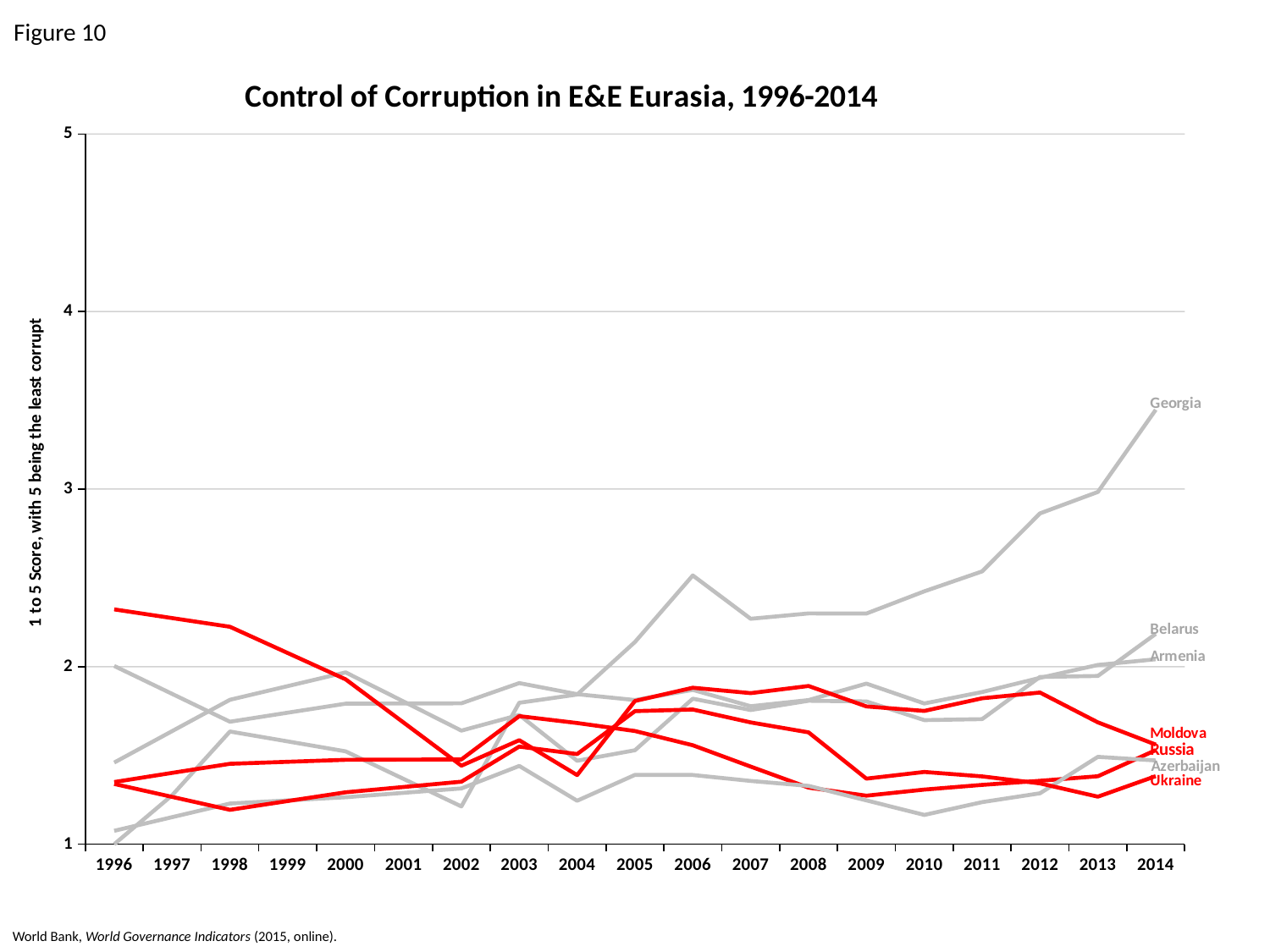
Which country has the higher score in 2014, Moldova or Ukraine? Moldova Does Georgia's score rise or fall between 2009 and 2014? rise Which country has the highest Control of Corruption score in 2014? Georgia Is the value for Ukraine in 2014 greater or less than 2? less How many countries are plotted as lines on the chart? 7 What is the label on the vertical axis of the chart? 1 to 5 Score, with 5 being the least corrupt What is the title of the chart? Control of Corruption in E&E Eurasia, 1996-2014 How many years are shown along the x axis of the chart? 19 What kind of chart is shown on the slide? line chart Is the value for Georgia in 2014 greater or less than 3? greater Is the value for Georgia in 2011 greater or less than 2? greater Which country has the higher score in 2014, Georgia or Belarus? Georgia